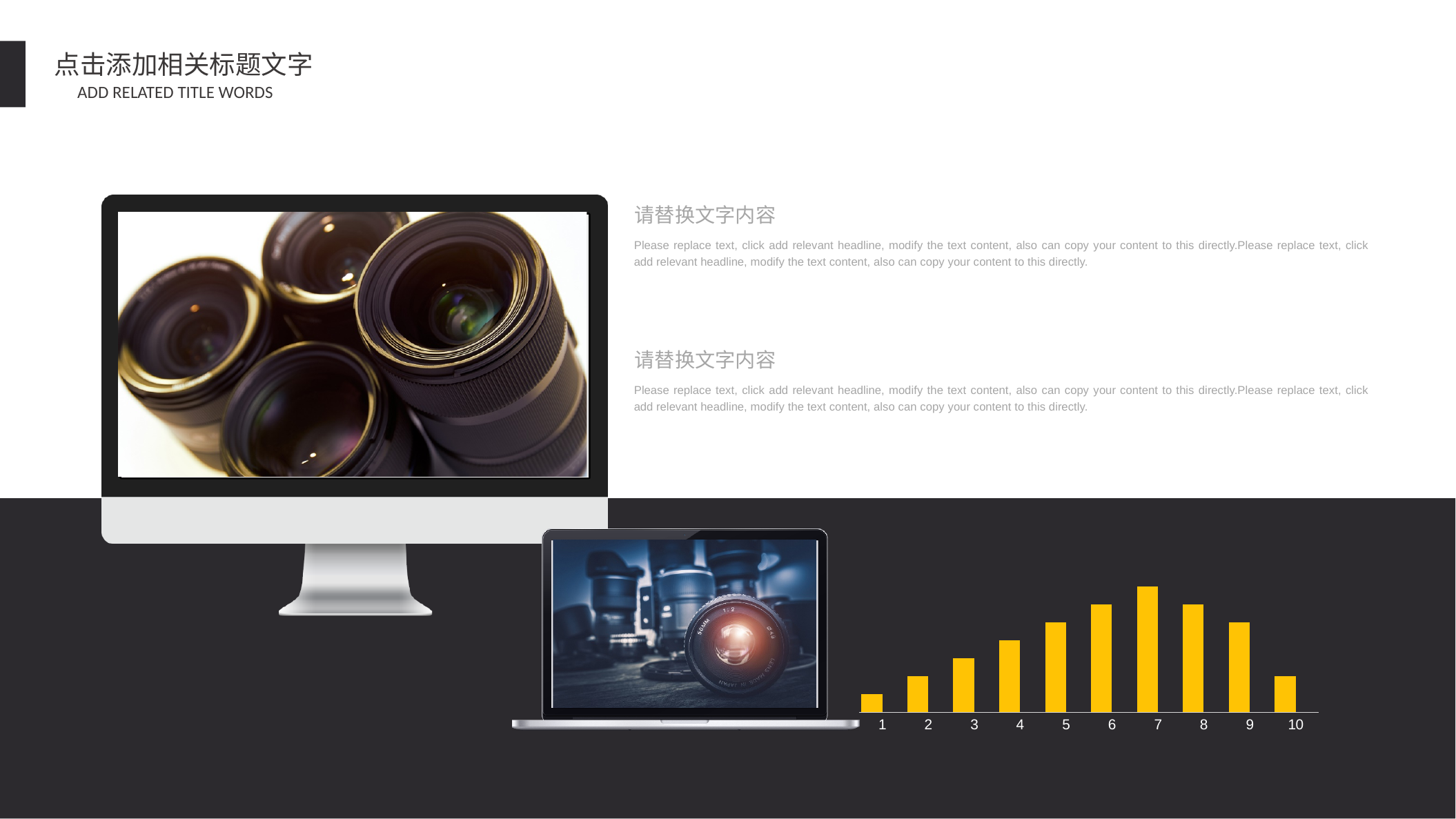
Which category has the tallest bar in the bar chart? 7 How many categories are shown on the x axis of the bar chart? 10 In the bar chart, is the bar for category 4 taller or shorter than the bar for category 2? taller Do the values in the bar chart rise or fall from category 7 to category 10? fall In the bar chart, which is larger, the value for category 5 or the value for category 1? 5 What colour are the bars in the bar chart? yellow In the bar chart, which is larger, the value for category 7 or the value for category 3? 7 Which category has the shortest bar in the bar chart? 1 What kind of chart is shown at the bottom right of the slide? bar chart What is the label of the first category on the x axis of the bar chart? 1 Do the values in the bar chart rise or fall from category 1 to category 7? rise